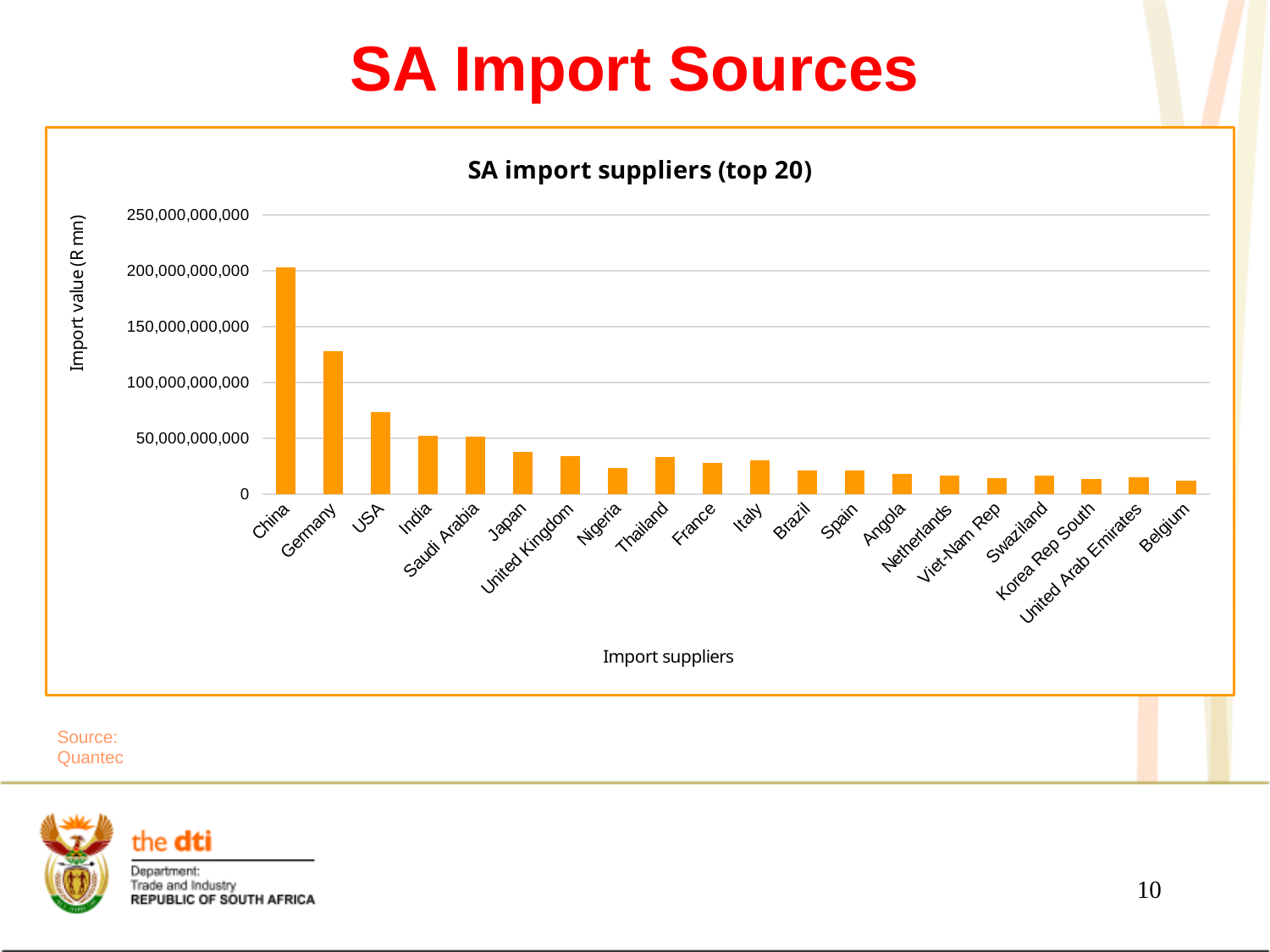
Is the import value for USA greater or less than 100,000,000,000? less Which has a larger import value, China or Germany? China What is the title of the chart? SA import suppliers (top 20) Do the import values generally rise or fall moving from left to right along the x axis? Fall Which import supplier has the highest import value? China How many import suppliers are plotted in the chart? 20 Which has a larger import value, USA or India? USA What is the label of the vertical axis? Import value (R mn) Is the import value for Germany greater or less than 100,000,000,000? greater Is the import value for China greater or less than 150,000,000,000? greater What kind of chart is shown on the slide? Bar chart